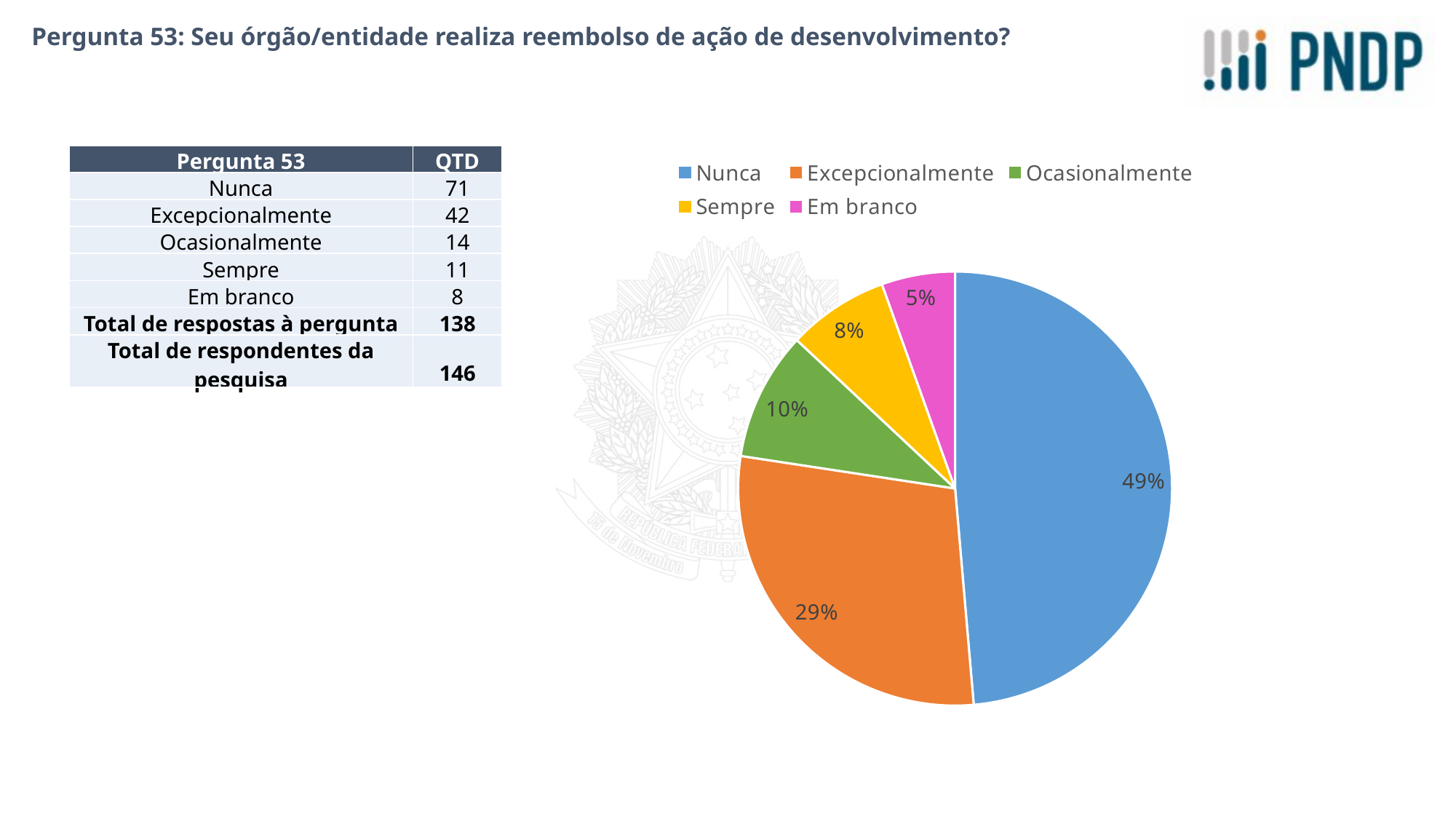
What percentage of the pie chart does the Nunca slice represent? 49% What percentage is shown for the Sempre slice? 8% What percentage is shown for the Ocasionalmente slice? 10% Which category has the largest slice of the pie chart? Nunca How many entries does the legend list? 5 Which slice is larger, Excepcionalmente or Ocasionalmente? Excepcionalmente Which category has the smallest slice of the pie chart? Em branco What type of chart is shown on the slide? pie chart How many slices does the pie chart have? 5 What is the difference in percentage points between the Nunca slice and the Excepcionalmente slice? 20 percentage points